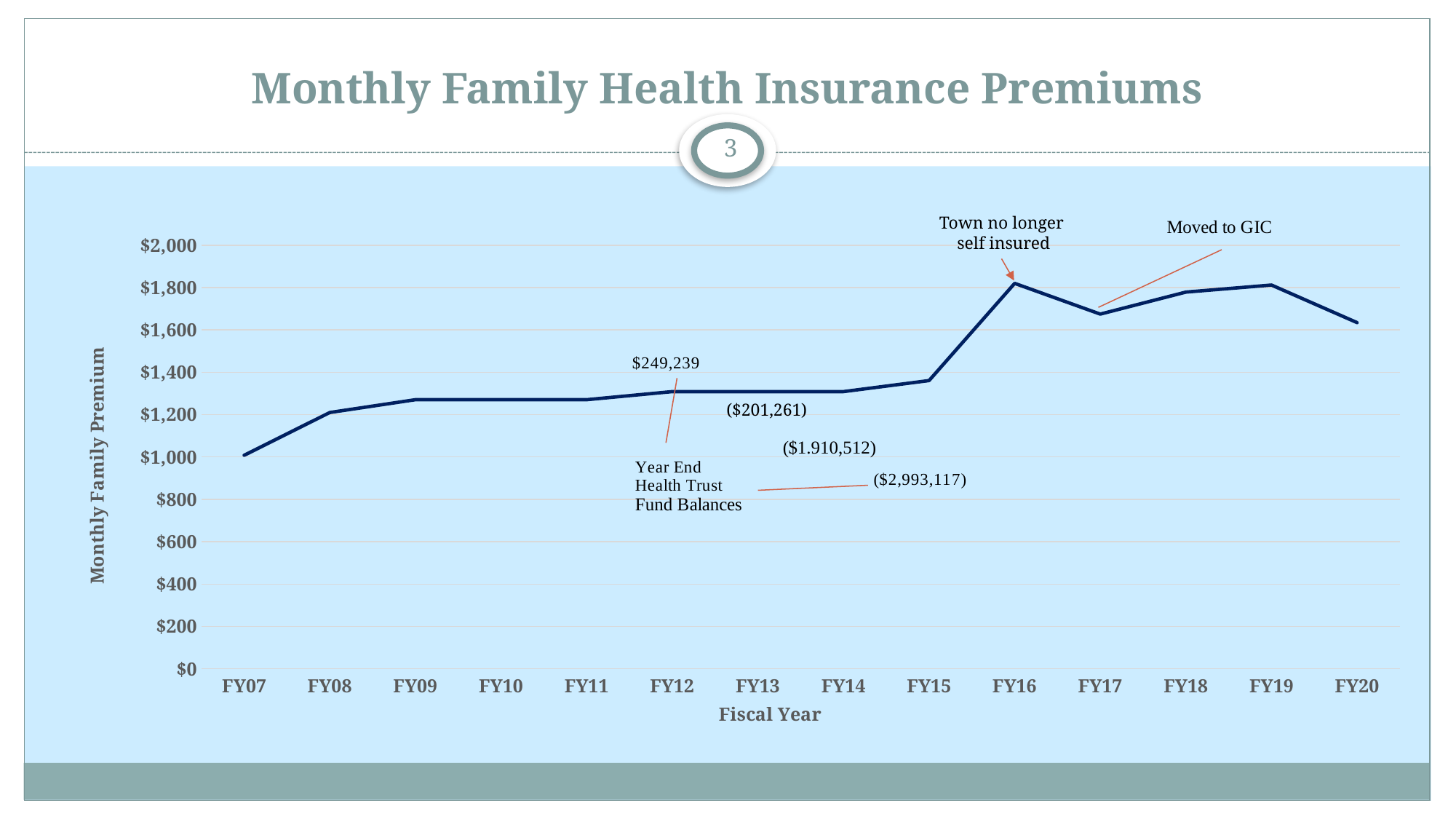
Is the monthly family premium for FY20 greater or less than $1,400? greater Is the monthly family premium for FY07 greater or less than $1,200? less Is the monthly family premium for FY16 greater or less than $1,600? greater Which is larger, the monthly family premium for FY19 or for FY20? FY19 Does the monthly family premium rise or fall from FY07 to FY16? rise Which is larger, the monthly family premium for FY17 or for FY18? FY18 What kind of chart is shown on the slide? line chart What is the title of the chart? Monthly Family Health Insurance Premiums Which fiscal year is annotated with "Moved to GIC"? FY17 How many fiscal years are plotted on the x axis? 14 Which fiscal year has the lowest monthly family premium? FY07